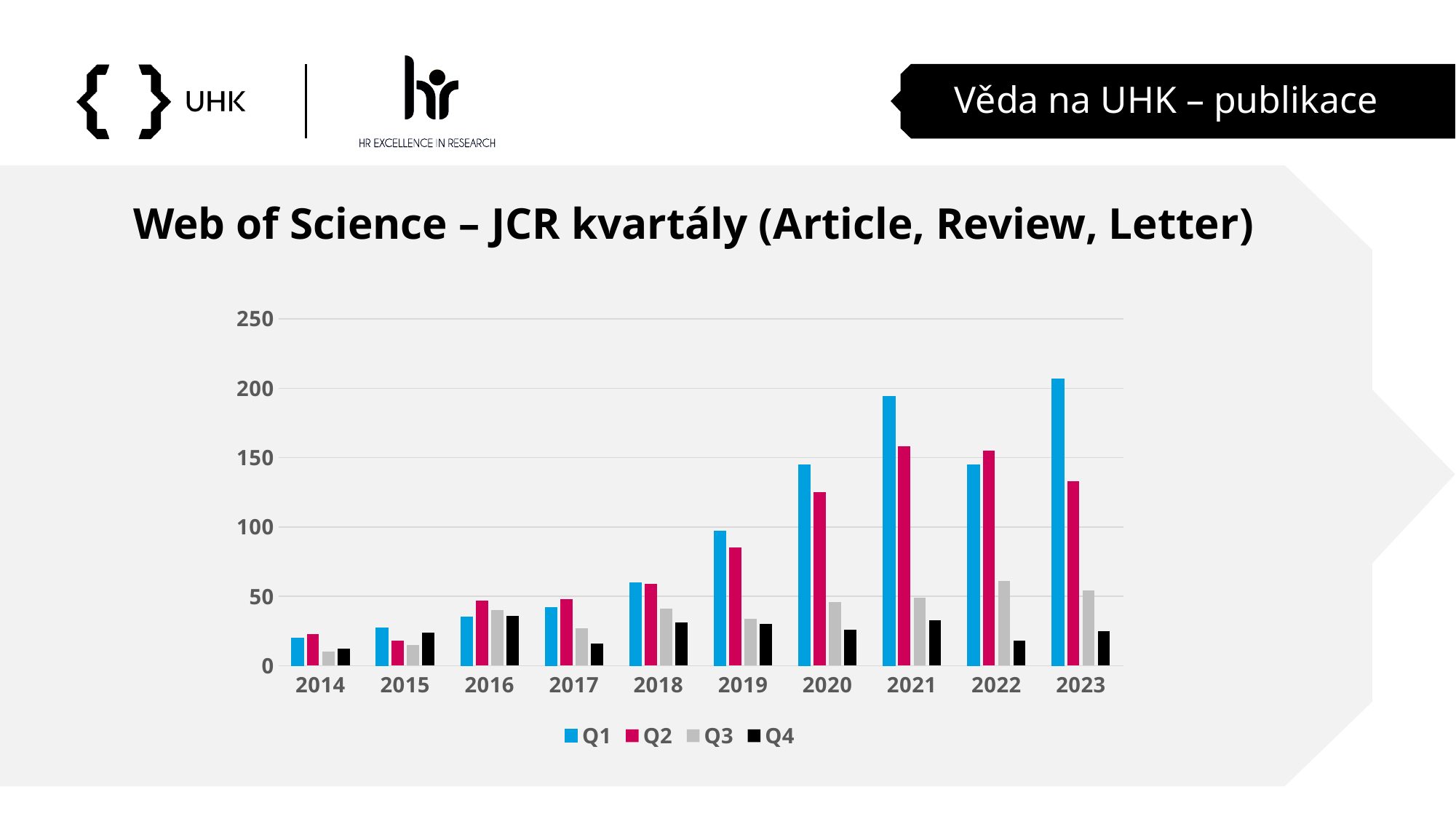
How many series does the legend list? 4 In which year is the Q1 value highest? 2023 In 2020, which is larger, the Q1 value or the Q2 value? Q1 Is the Q4 value for 2021 greater or less than 50? less What kind of chart is shown on the slide? bar chart Is the Q3 value for 2022 greater or less than 50? greater Is the Q1 value for 2023 greater or less than 200? greater In which year is the Q1 value lowest? 2014 Does the Q1 value rise or fall from 2014 to 2021? rise How many years are shown on the x axis? 10 In 2022, which is larger, the Q1 value or the Q2 value? Q2